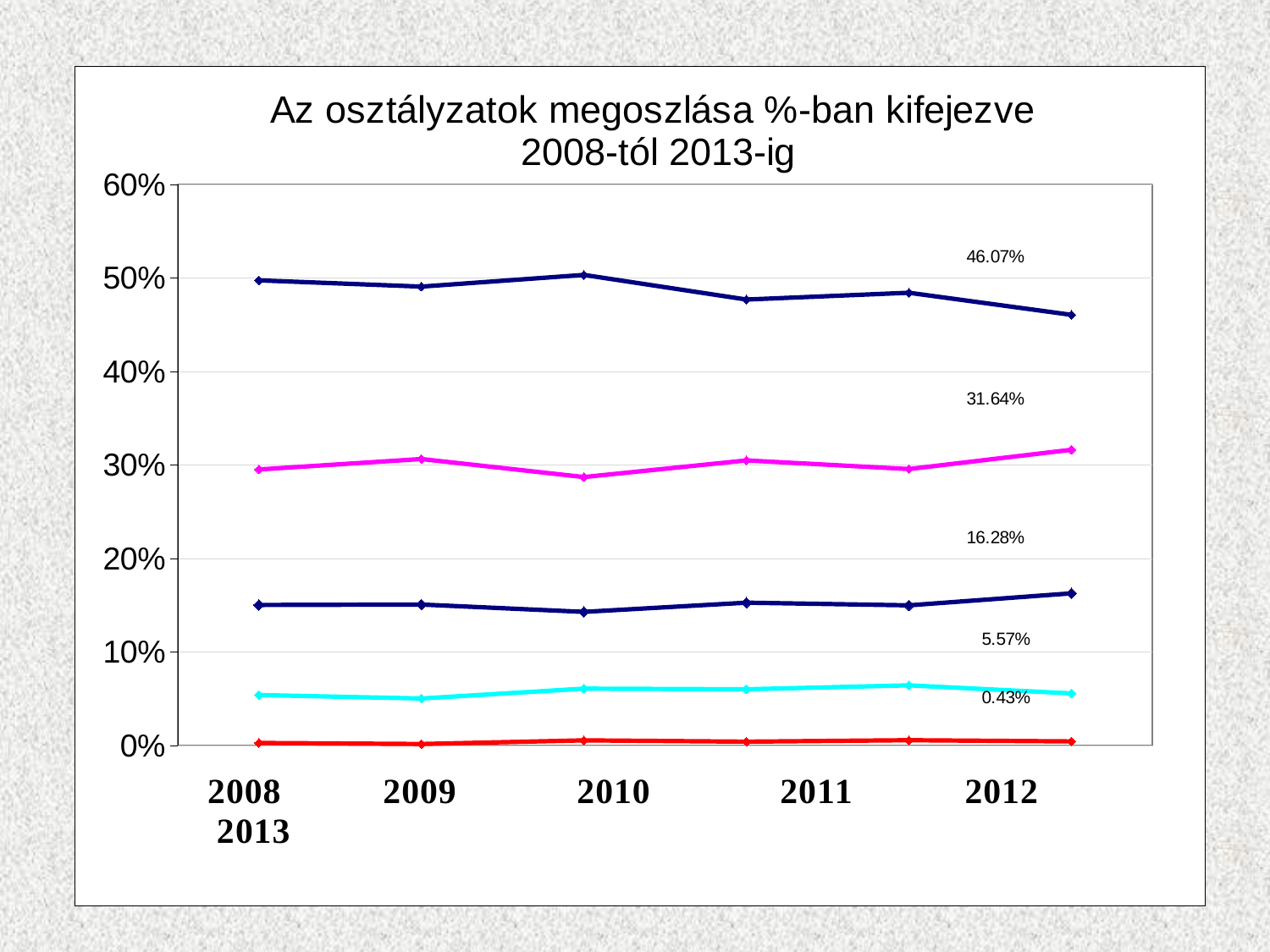
What is the labelled value of the magenta line at its last point, 2013? 31.64% Does the topmost dark blue line rise or fall overall from 2008 to 2013? fall What type of chart is shown on the slide? line chart What is the difference between the 2013 values of the topmost dark blue line (46.07%) and the magenta line (31.64%)? 14.43% What is the title of the chart? Az osztályzatok megoszlása %-ban kifejezve 2008-tól 2013-ig Which line has the lowest value in 2013? the red line (0.43%) How many years are shown along the x axis of the chart? 6 What is the labelled value of the red line at its last point, 2013? 0.43% Is the value of the topmost dark blue line in 2008 greater or less than 40%? greater What is the labelled value of the cyan line at its last point, 2013? 5.57% Which line has the highest value in 2013? the topmost dark blue line (46.07%) What is the labelled value of the topmost (dark blue) line at its last point, 2013? 46.07%